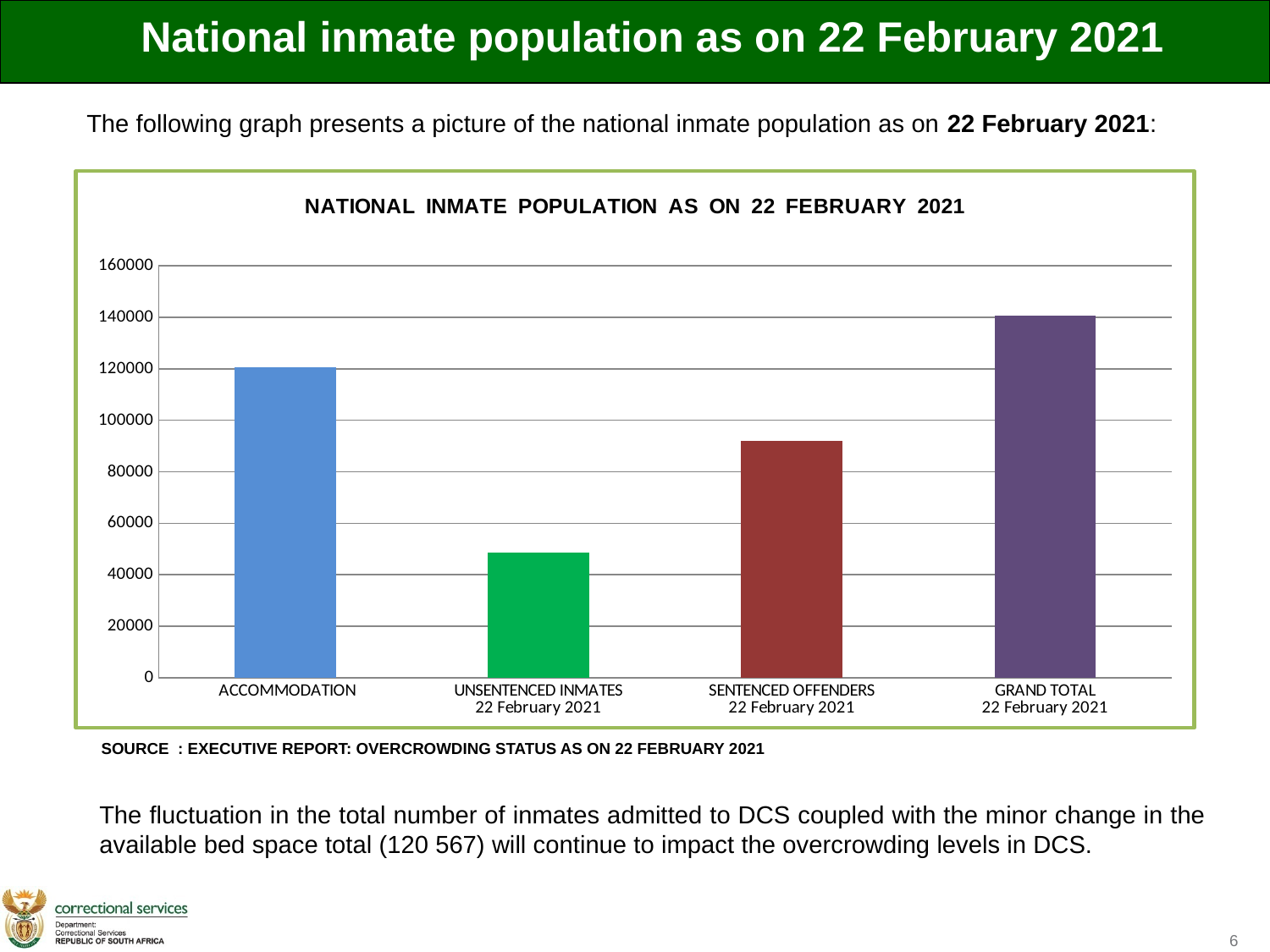
How many categories are plotted on the chart? 4 What kind of chart is shown on the slide? bar chart Is the value for GRAND TOTAL greater or less than 120000? greater Which category has the highest value? GRAND TOTAL 22 February 2021 Is the value for UNSENTENCED INMATES greater or less than 60000? less Which category has the lowest value? UNSENTENCED INMATES 22 February 2021 Is the value for SENTENCED OFFENDERS greater or less than 80000? greater Which is larger, the value for SENTENCED OFFENDERS or the value for UNSENTENCED INMATES? SENTENCED OFFENDERS Which is larger, the value for ACCOMMODATION or the value for SENTENCED OFFENDERS? ACCOMMODATION What colour is the bar for GRAND TOTAL? purple What is the title of the chart? NATIONAL INMATE POPULATION AS ON 22 FEBRUARY 2021